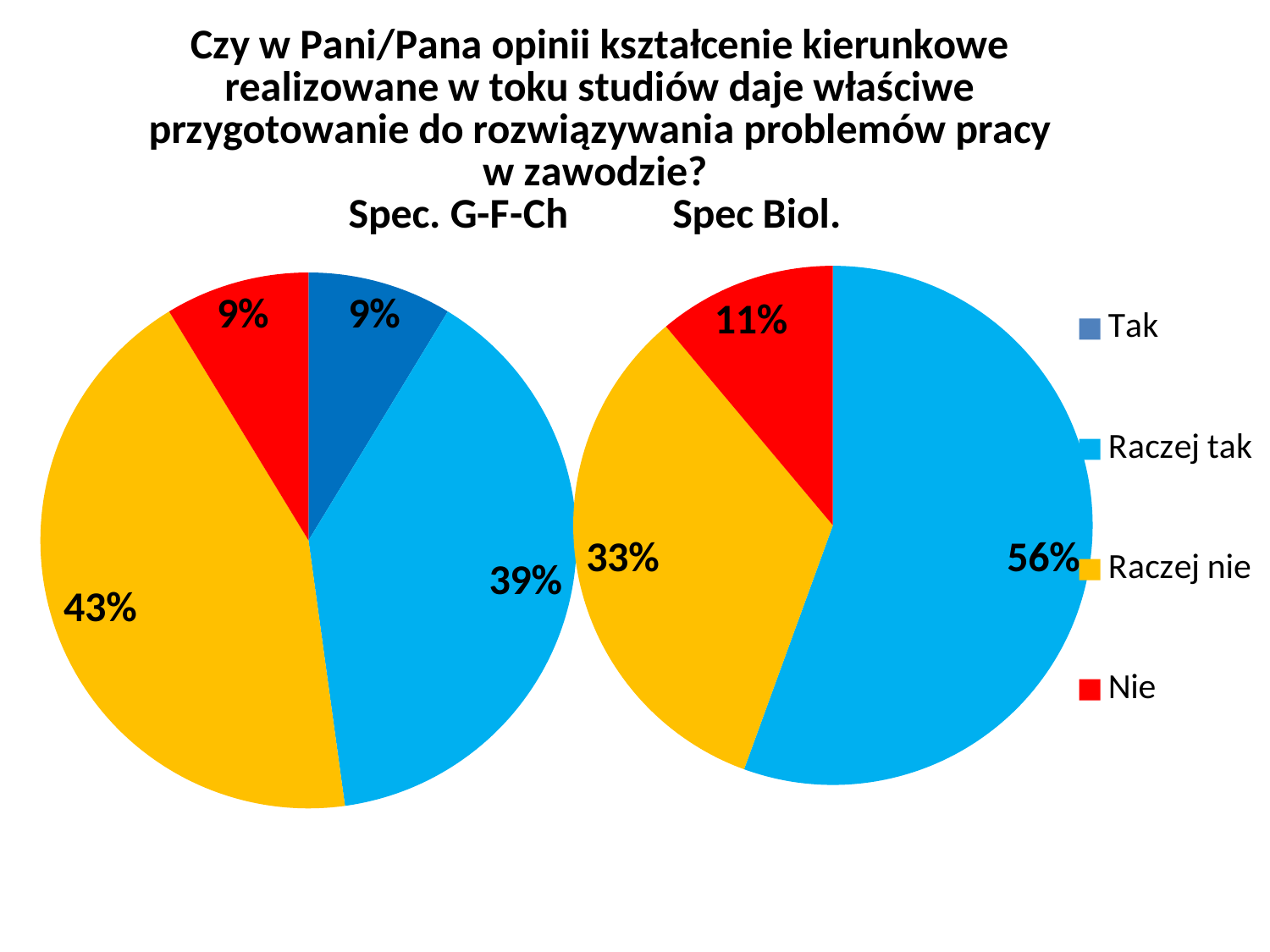
In the Spec. G-F-Ch pie chart, which category has the largest slice? Raczej nie In the Spec. G-F-Ch pie chart, what share is labelled for Raczej nie? 43% In the Spec Biol. pie chart, what share is labelled for Raczej tak? 56% In the Spec Biol. pie chart, which category has the largest slice? Raczej tak In the Spec Biol. pie chart, what share is labelled for Raczej nie? 33% In the Spec Biol. pie chart, what share is labelled for Nie? 11% How many entries does the legend list? 4 What is the difference between the Raczej tak shares in the Spec Biol. chart and the Spec. G-F-Ch chart? 17% In the Spec Biol. pie chart, which labelled category has the smallest slice? Nie What type of chart is used on this slide? Pie chart Which chart has the larger Nie share, Spec. G-F-Ch or Spec Biol.? Spec Biol. In the Spec. G-F-Ch pie chart, what share is labelled for Raczej tak? 39%